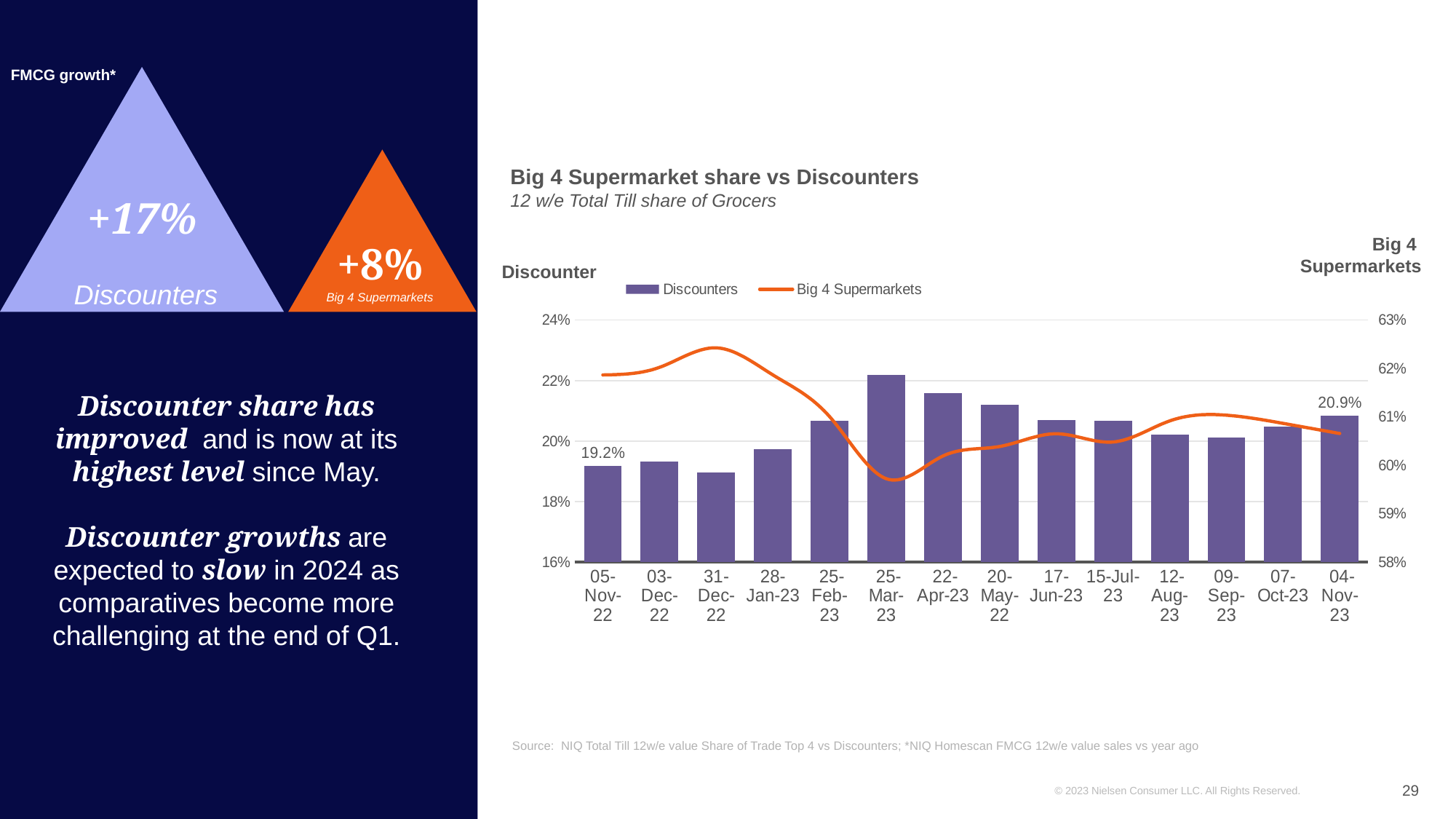
What kind of chart is shown on the slide? Bar chart with a line overlay What is the Discounters share for 05-Nov-22? 19.2% Which is larger, the Discounters bar for 25-Mar-23 or for 22-Apr-23? 25-Mar-23 Which period has the highest Discounters bar? 25-Mar-23 Is the Discounters value for 25-Feb-23 greater or less than 20%? greater By how many percentage points did the Discounters share change from 05-Nov-22 to 04-Nov-23? 1.7 percentage points What is the Discounters share for 04-Nov-23? 20.9% How many series does the chart legend list? 2 Is the Discounters value for 31-Dec-22 greater or less than 20%? less How many time periods are shown along the x axis of the chart? 14 Does the Big 4 Supermarkets line end higher or lower than where it starts? lower What is the title of the chart? Big 4 Supermarket share vs Discounters